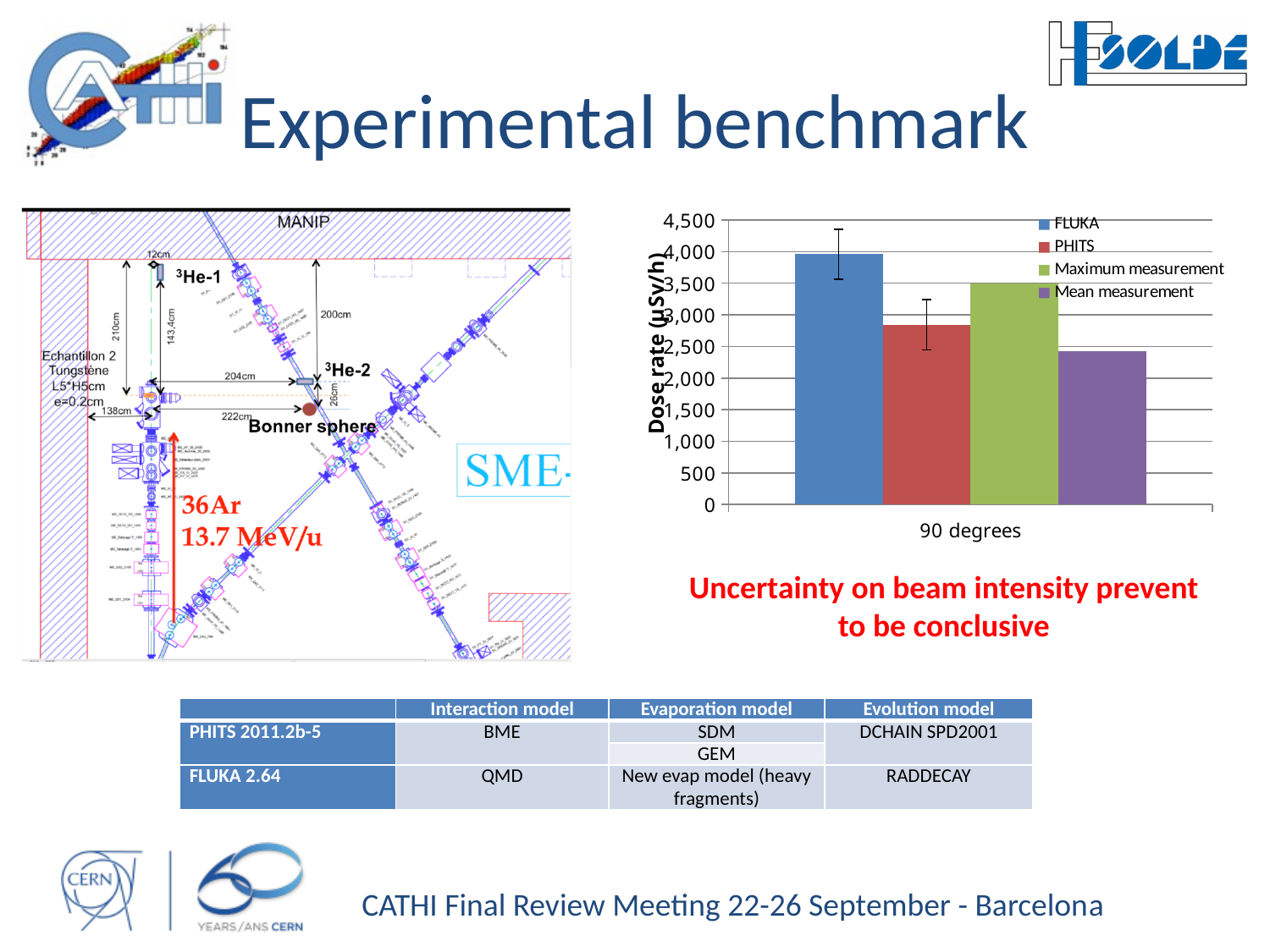
Which is larger in the chart, the Maximum measurement or the Mean measurement? Maximum measurement What is the category label shown on the x axis of the chart? 90 degrees Which is larger in the chart, the FLUKA value or the PHITS value? FLUKA Which series has the lowest dose rate in the chart? Mean measurement Is the value for PHITS greater or less than 3,000? less Is the value for FLUKA greater or less than 3,500? greater What is the label on the y axis of the chart? Dose rate (µSv/h) How many series does the chart's legend list? 4 What kind of chart is shown on the slide? bar chart Is the value for Mean measurement greater or less than 3,000? less Which series has the highest dose rate in the chart? FLUKA How many categories are shown on the x axis of the chart? 1